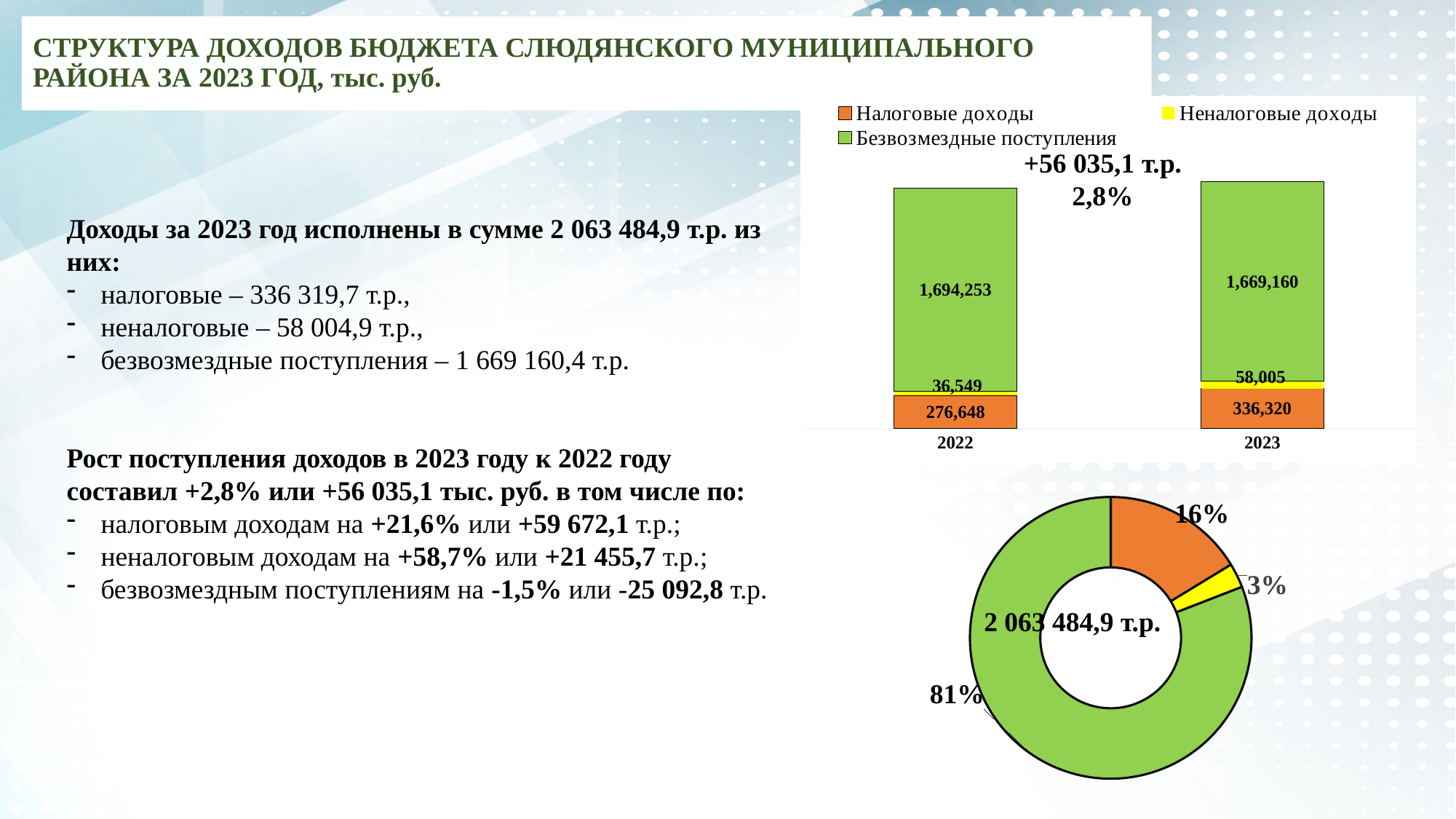
In the stacked bar chart at the top right, by how much did Налоговые доходы increase from 2022 to 2023? 59,672 In the stacked bar chart at the top right, what is the difference between Неналоговые доходы in 2023 and in 2022? 21,456 In the stacked bar chart at the top right, how many years are shown on the x axis? 2 What type of chart is shown at the bottom right of the slide? Doughnut chart In the stacked bar chart at the top right, which year has the larger value for Безвозмездные поступления, 2022 or 2023? 2022 In the stacked bar chart at the top right, what is the value of Налоговые доходы for 2023? 336,320 In the stacked bar chart at the top right, what is the value of Безвозмездные поступления for 2022? 1,694,253 In the stacked bar chart at the top right, how many series does the legend list? 3 In the doughnut chart at the bottom right, what value is printed in the centre? 2 063 484,9 т.р. In the stacked bar chart at the top right, what is the value of Неналоговые доходы for 2022? 36,549 In the doughnut chart at the bottom right, what share does the green segment (Безвозмездные поступления) have? 81% In the stacked bar chart at the top right, what is the total of the 2023 bar? 2,063,485